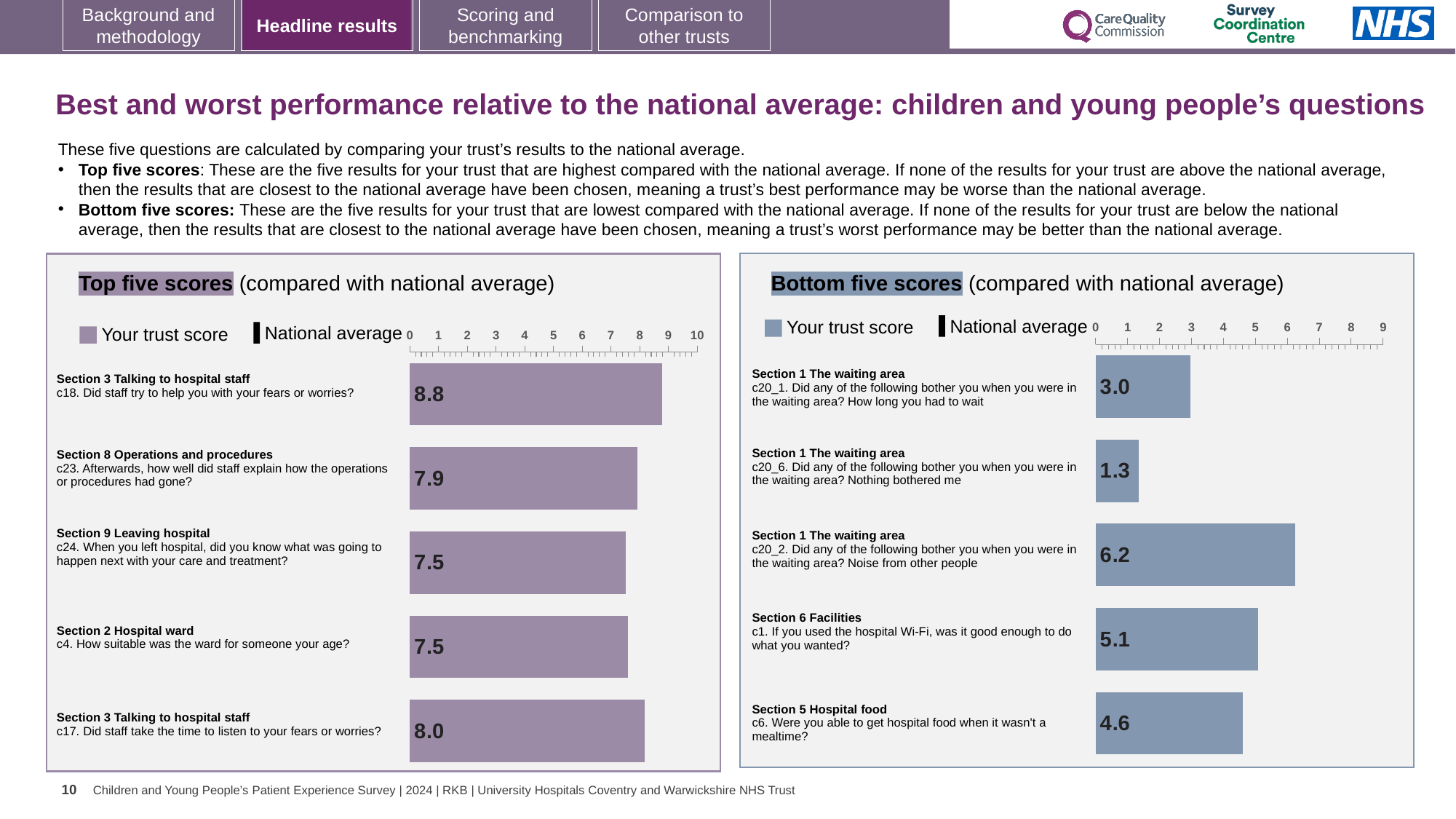
In the Top five scores chart, how many questions are plotted? 5 In the Top five scores chart, what is the trust score for c18 (Did staff try to help you with your fears or worries?)? 8.8 In the Bottom five scores chart, which question has the highest trust score? c20_2. Did any of the following bother you when you were in the waiting area? Noise from other people In the Top five scores chart, which question has the highest trust score? c18. Did staff try to help you with your fears or worries? In the Top five scores chart, what is the difference between the scores for c18 and c17? 0.8 In the Bottom five scores chart, which is larger: the score for c6 (hospital food) or c20_1 (how long you had to wait)? c6 (hospital food) In the Bottom five scores chart, what is the difference between the scores for c20_2 and c1? 1.1 In the Bottom five scores chart, what is the trust score for c1 (hospital Wi-Fi)? 5.1 In the Bottom five scores chart, what is the trust score for c20_6 (Nothing bothered me)? 1.3 In the Bottom five scores chart, which question has the lowest trust score? c20_6. Did any of the following bother you when you were in the waiting area? Nothing bothered me What type of chart is used in the Top five scores panel? Bar chart In the Top five scores chart, what is the trust score for c23 (how well did staff explain how the operations or procedures had gone)? 7.9